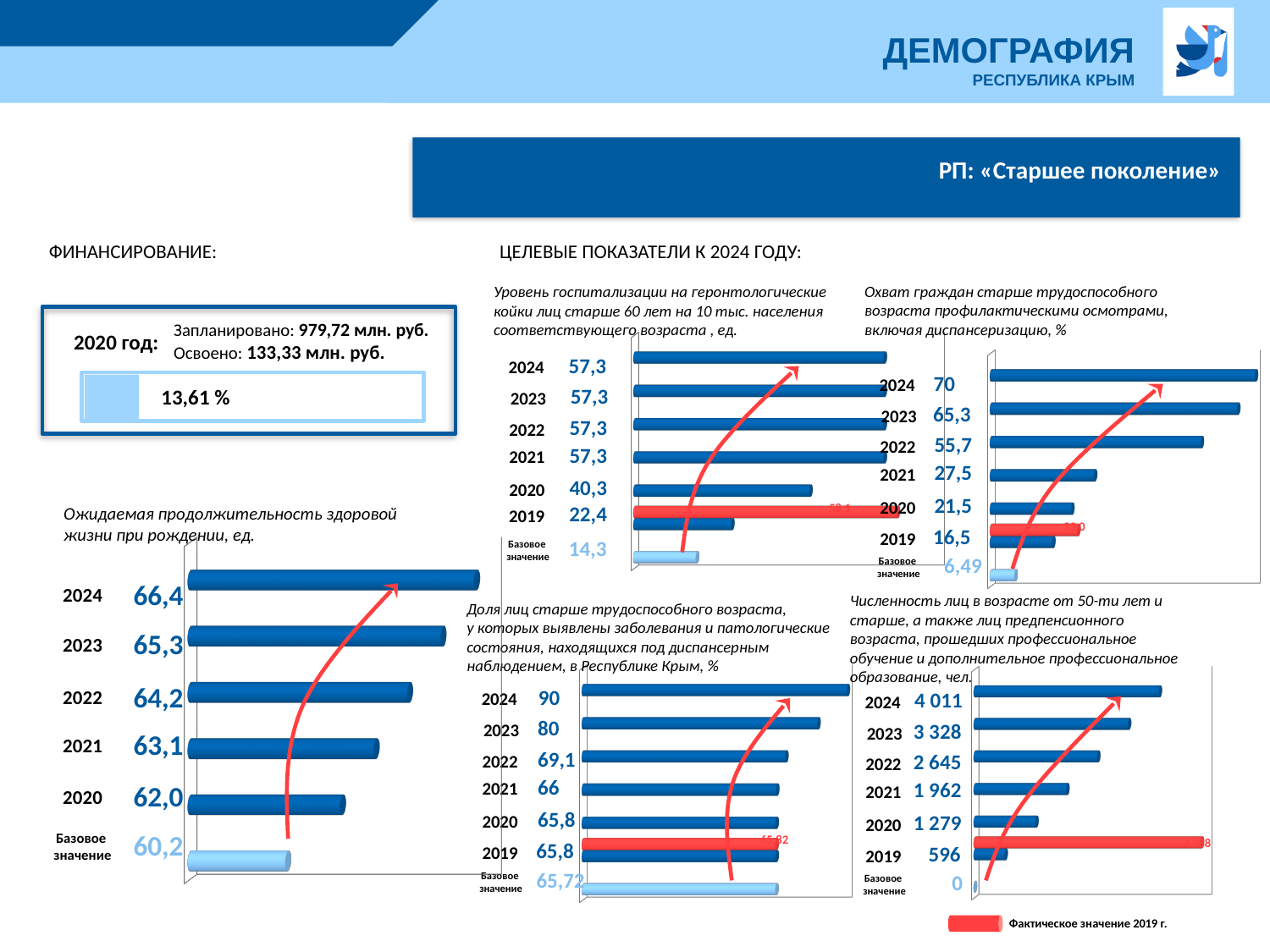
In the chart 'Численность лиц в возрасте от 50-ти лет и старше, а также лиц предпенсионного возраста, прошедших профессиональное обучение и дополнительное профессиональное образование, чел.', what is the value for 2024? 4 011 In the chart 'Ожидаемая продолжительность здоровой жизни при рождении, ед.', what is the 'Базовое значение'? 60,2 In the chart 'Доля лиц старше трудоспособного возраста, у которых выявлены заболевания и патологические состояния, находящихся под диспансерным наблюдением, в Республике Крым, %', is the value for 2022 larger or the value for 2021? 2022 In the chart 'Охват граждан старше трудоспособного возраста профилактическими осмотрами, включая диспансеризацию, %', which year has the highest value? 2024 In the chart 'Численность лиц в возрасте от 50-ти лет и старше, а также лиц предпенсионного возраста, прошедших профессиональное обучение и дополнительное профессиональное образование, чел.', do the values rise or fall from 2019 to 2024? rise In the chart 'Уровень госпитализации на геронтологические койки лиц старше 60 лет на 10 тыс. населения соответствующего возраста, ед.', what is the value for 2020? 40,3 What type of chart is 'Ожидаемая продолжительность здоровой жизни при рождении, ед.'? bar chart In the chart 'Доля лиц старше трудоспособного возраста, у которых выявлены заболевания и патологические состояния, находящихся под диспансерным наблюдением, в Республике Крым, %', what is the value for 2023? 80 In the chart 'Ожидаемая продолжительность здоровой жизни при рождении, ед.', what is the difference between the 2024 value and the 2020 value? 4,4 In the chart 'Ожидаемая продолжительность здоровой жизни при рождении, ед.', what is the value for 2024? 66,4 In the chart 'Уровень госпитализации на геронтологические койки лиц старше 60 лет на 10 тыс. населения соответствующего возраста, ед.', which category has the lowest value? Базовое значение In the chart 'Охват граждан старше трудоспособного возраста профилактическими осмотрами, включая диспансеризацию, %', what is the value for 2022? 55,7